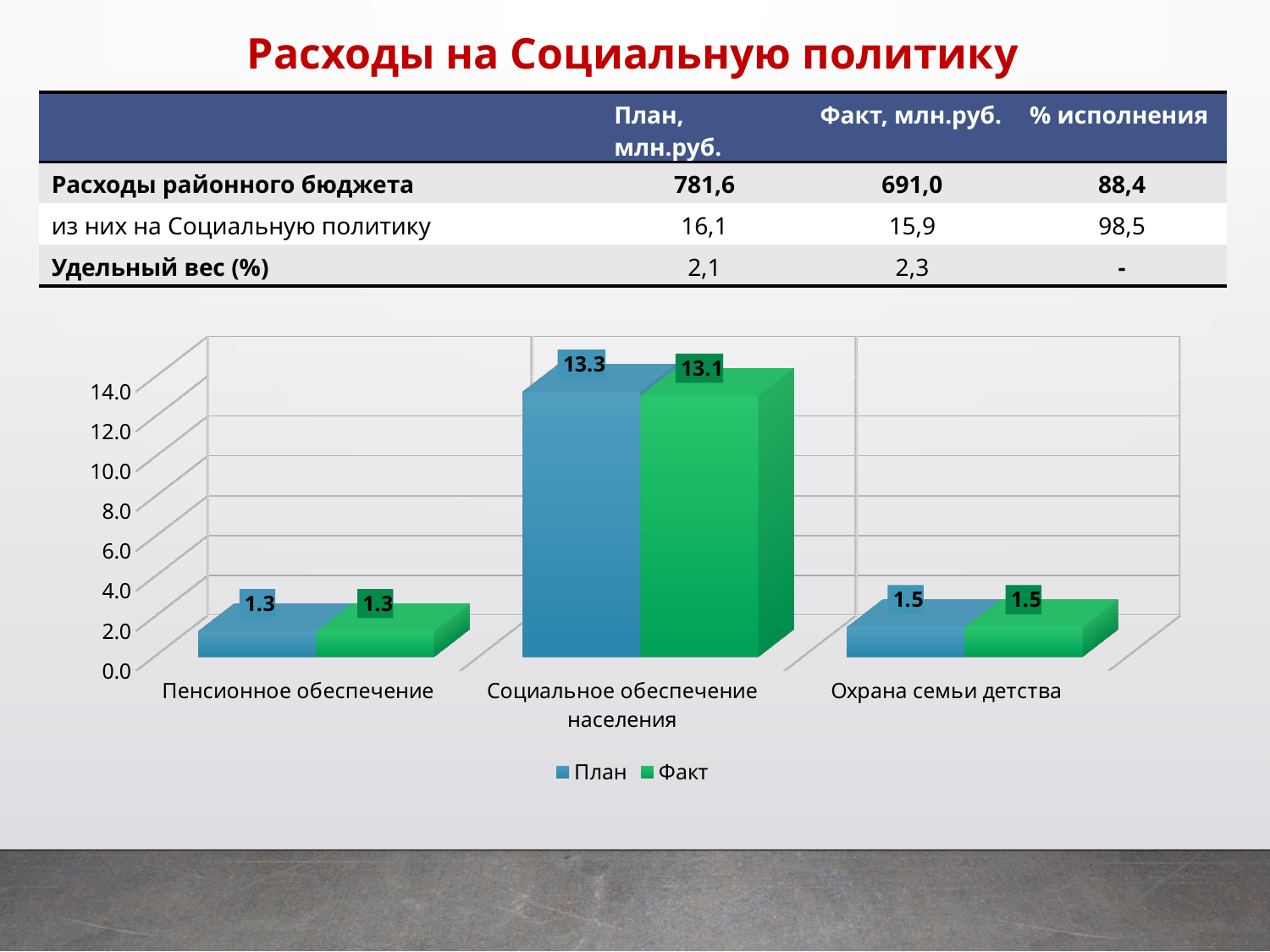
What is the План value for Пенсионное обеспечение? 1.3 Which is larger for Охрана семьи детства: the План value or the Факт value? They are equal (1.5) What is the План value for Социальное обеспечение населения? 13.3 Which category has the lowest Факт value? Пенсионное обеспечение What is the difference between the План and Факт values for Социальное обеспечение населения? 0.2 What kind of chart is shown on the slide? Bar chart How many series does the chart legend list? 2 What are the two series named in the chart legend? План and Факт How many categories are shown on the x axis of the chart? 3 What is the Факт value for Охрана семьи детства? 1.5 Which category has the highest План value? Социальное обеспечение населения What is the Факт value for Социальное обеспечение населения? 13.1